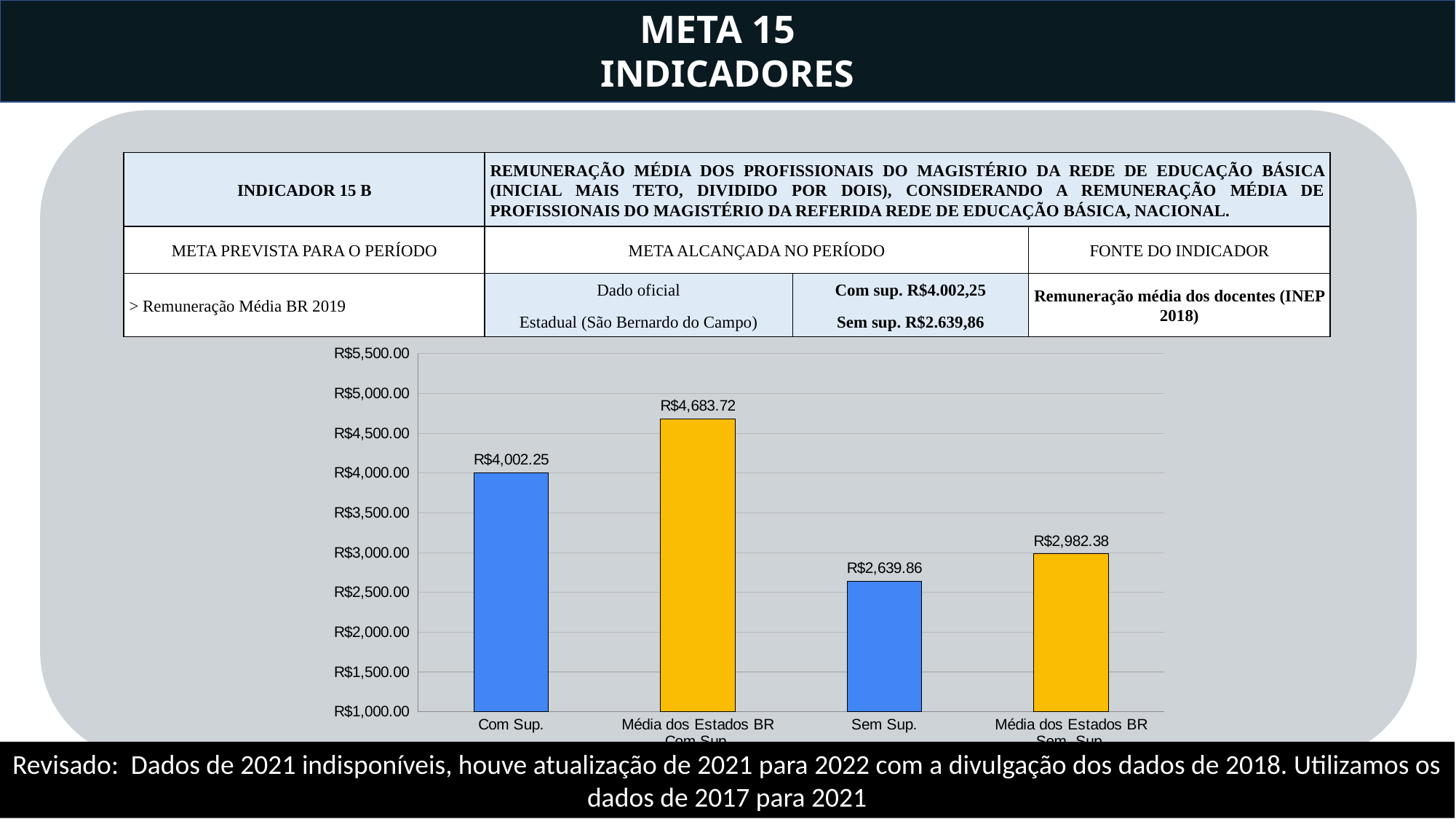
What kind of chart is shown on the slide? bar chart What is the difference between the Média dos Estados BR Sem Sup. bar and the Sem Sup. bar? R$342.52 Which category has the lowest value in the chart? Sem Sup. How many bars are shown in the chart? 4 Is the value for Sem Sup. greater or less than R$3,000.00? less What is the value of the Com Sup. bar? R$4,002.25 Which is larger, the Com Sup. bar or the Sem Sup. bar? Com Sup. What is the value of the Média dos Estados BR Sem Sup. bar? R$2,982.38 What is the value of the Média dos Estados BR Com Sup. bar? R$4,683.72 Which category has the highest value in the chart? Média dos Estados BR Com Sup. What is the value of the Sem Sup. bar? R$2,639.86 What is the difference between the Média dos Estados BR Com Sup. bar and the Com Sup. bar? R$681.47